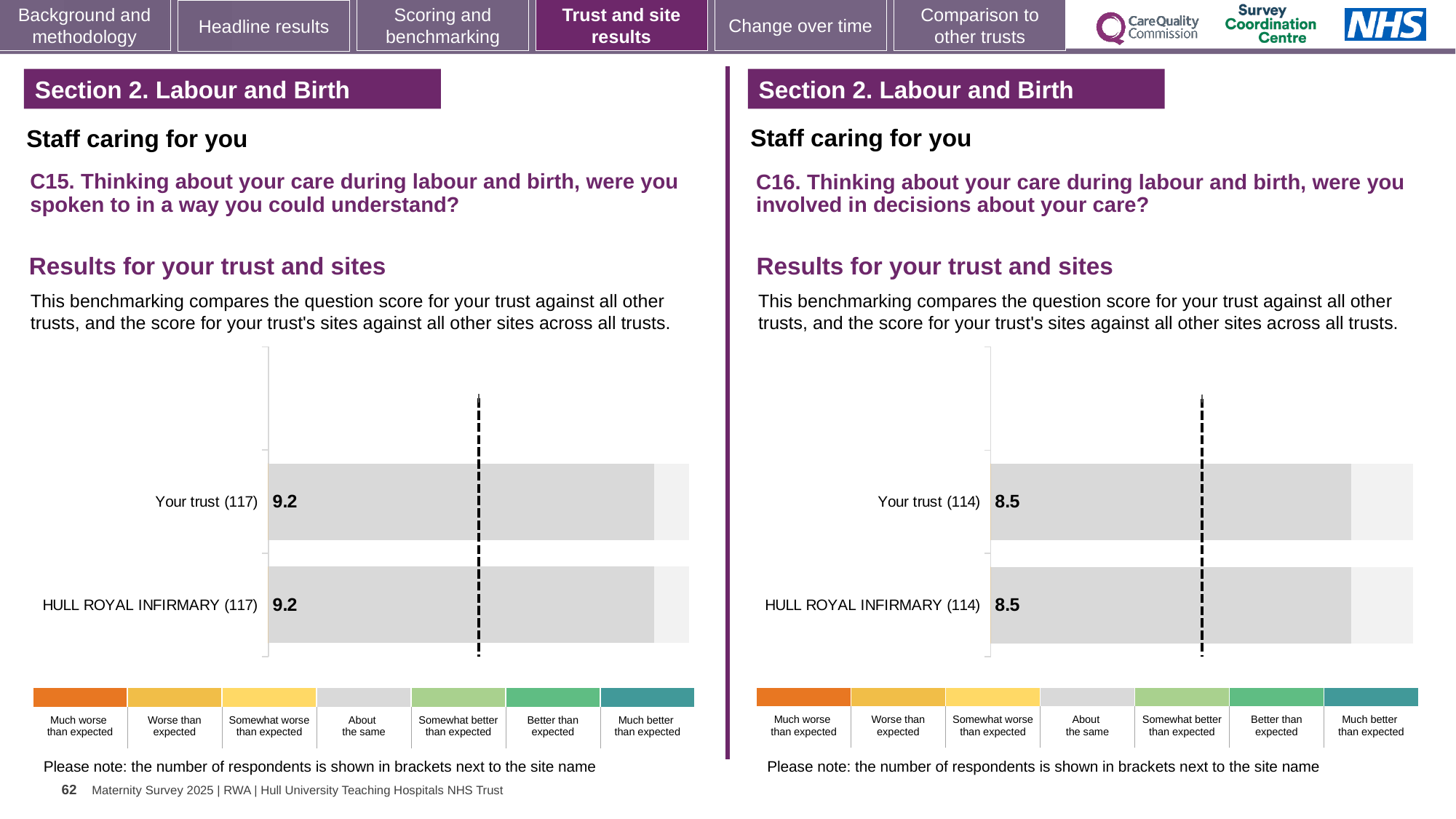
What kind of chart is used in the C15 chart on the left? Bar chart In the C15 chart on the left, what is the score for HULL ROYAL INFIRMARY? 9.2 In the C15 chart on the left, what is the score for Your trust? 9.2 What is the difference between the Your trust score in the C15 chart on the left and the Your trust score in the C16 chart on the right? 0.7 In the C15 chart on the left, what is the difference between the score for Your trust and the score for HULL ROYAL INFIRMARY? 0 In the C16 chart on the right, how many respondents are shown in brackets next to HULL ROYAL INFIRMARY? 114 In the C16 chart on the right, what is the score for Your trust? 8.5 Is the Your trust score in the C16 chart on the right greater or less than the Your trust score in the C15 chart on the left? less In the C16 chart on the right, what is the score for HULL ROYAL INFIRMARY? 8.5 In the C15 chart on the left, how many respondents are shown in brackets next to Your trust? 117 How many bars are plotted in the C16 chart on the right? 2